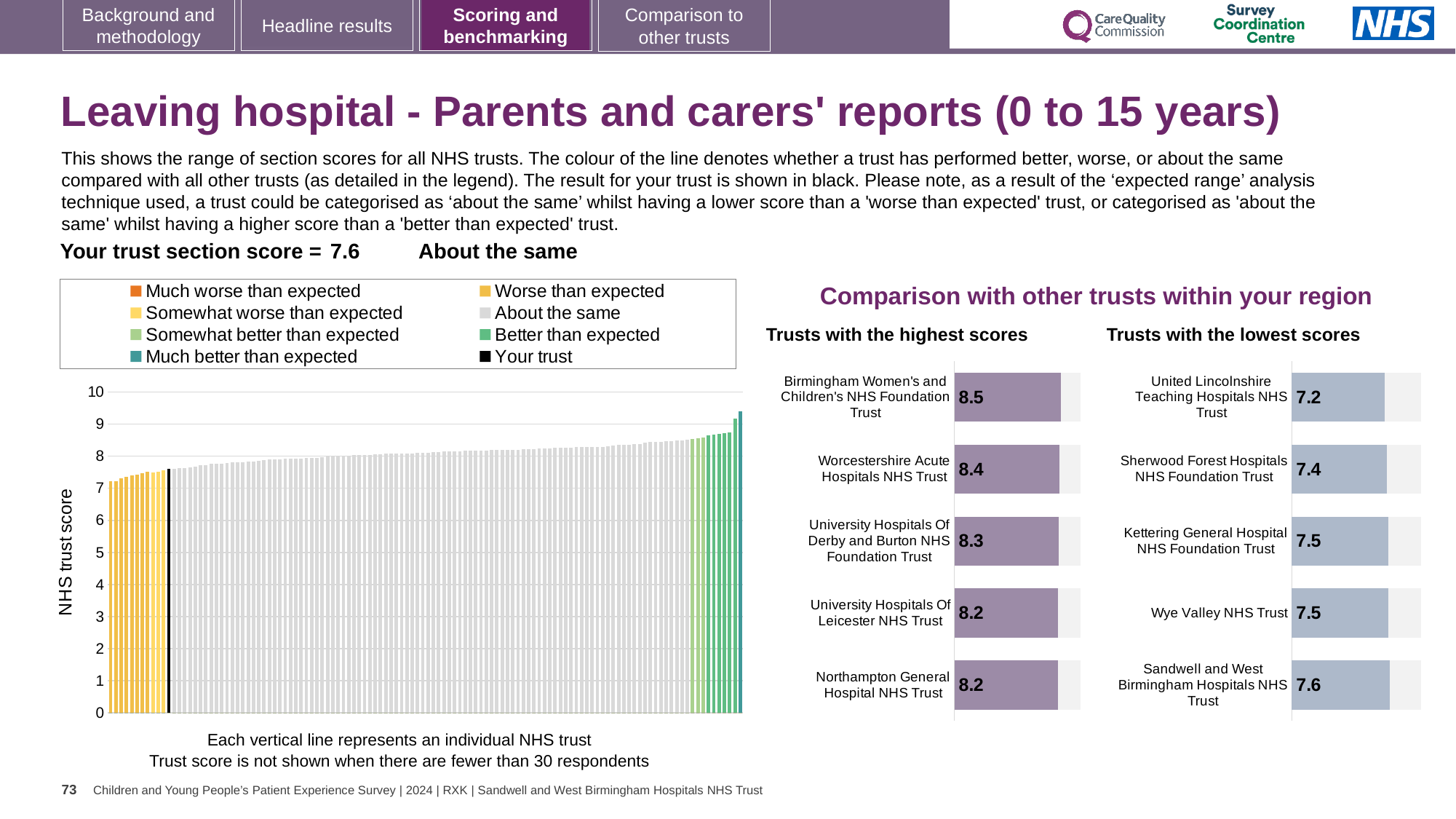
In the 'Trusts with the lowest scores' chart, which trust has the lowest score? United Lincolnshire Teaching Hospitals NHS Trust How many trusts are listed in the 'Trusts with the highest scores' chart? 5 In the 'Trusts with the lowest scores' chart, what is the difference between the scores of Sandwell and West Birmingham Hospitals NHS Trust and United Lincolnshire Teaching Hospitals NHS Trust? 0.4 How many entries does the legend above the large chart on the left list? 8 In the 'Trusts with the lowest scores' chart, what is the score for Sherwood Forest Hospitals NHS Foundation Trust? 7.4 In the 'Trusts with the highest scores' chart, what is the difference between the scores of Birmingham Women's and Children's NHS Foundation Trust and Northampton General Hospital NHS Trust? 0.3 In the large chart on the left, do the trust scores rise or fall from left to right? Rise In the 'Trusts with the lowest scores' chart, which has the higher score: Kettering General Hospital NHS Foundation Trust or Sherwood Forest Hospitals NHS Foundation Trust? Kettering General Hospital NHS Foundation Trust In the 'Trusts with the highest scores' chart, what is the score for Worcestershire Acute Hospitals NHS Trust? 8.4 In the 'Trusts with the lowest scores' chart, what is the score for Sandwell and West Birmingham Hospitals NHS Trust? 7.6 What kind of chart is the large chart on the left showing NHS trust scores? Bar chart In the 'Trusts with the highest scores' chart, which trust has the highest score? Birmingham Women's and Children's NHS Foundation Trust